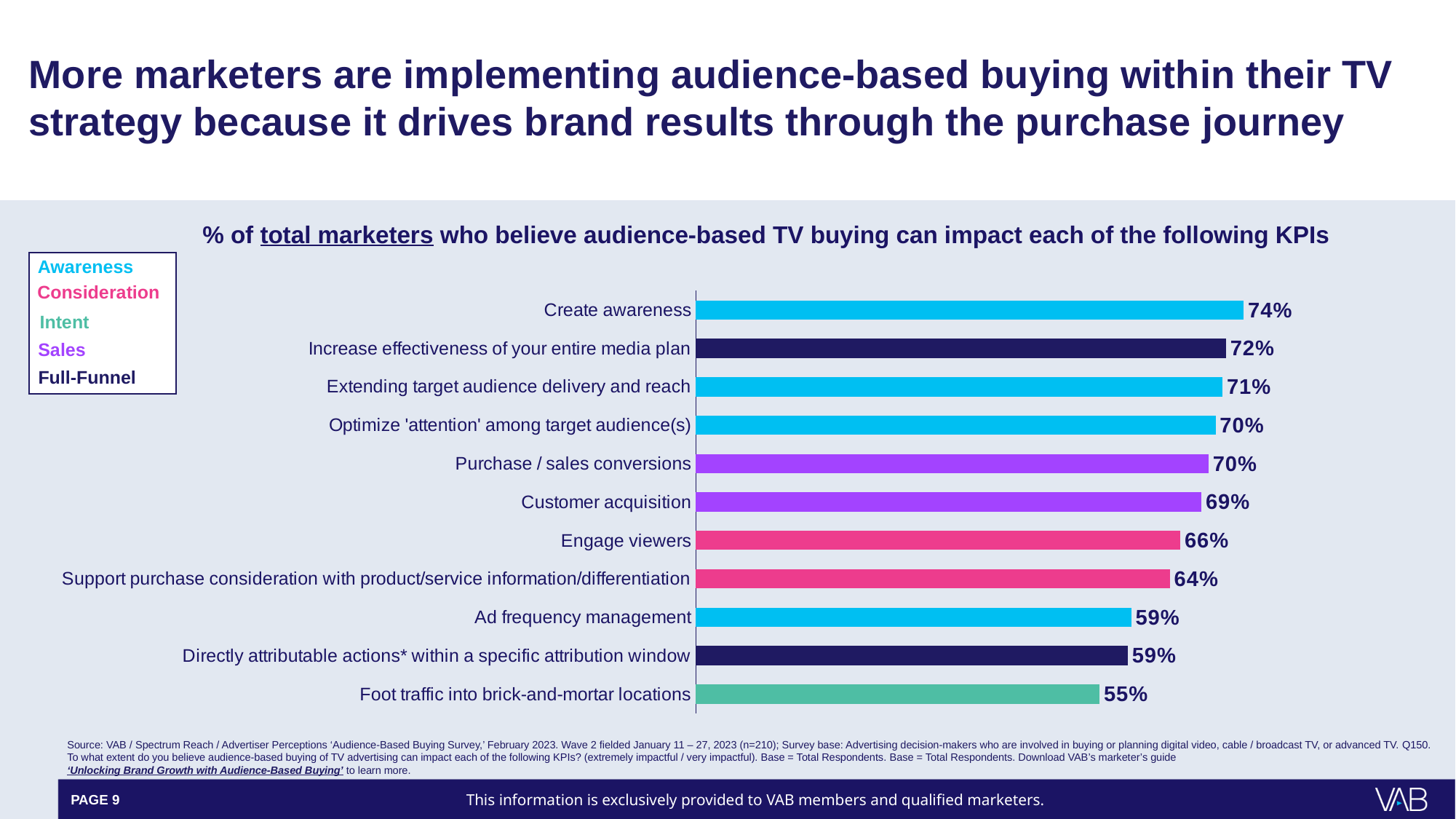
What type of chart is shown on the slide? Bar chart What is the value shown for 'Support purchase consideration with product/service information/differentiation'? 64% What is the difference between the values for 'Engage viewers' and 'Ad frequency management'? 7 percentage points Which KPI has the lowest percentage on the chart? Foot traffic into brick-and-mortar locations How many funnel categories does the legend list? 5 Which KPI has the highest percentage on the chart? Create awareness How many KPIs are plotted on the chart? 11 Which has a higher value: 'Increase effectiveness of your entire media plan' or 'Purchase / sales conversions'? Increase effectiveness of your entire media plan What is the value shown for 'Foot traffic into brick-and-mortar locations'? 55% What is the difference between the values for 'Create awareness' and 'Foot traffic into brick-and-mortar locations'? 19 percentage points What is the value shown for 'Customer acquisition'? 69% What percentage of total marketers believe audience-based TV buying can impact 'Create awareness'? 74%